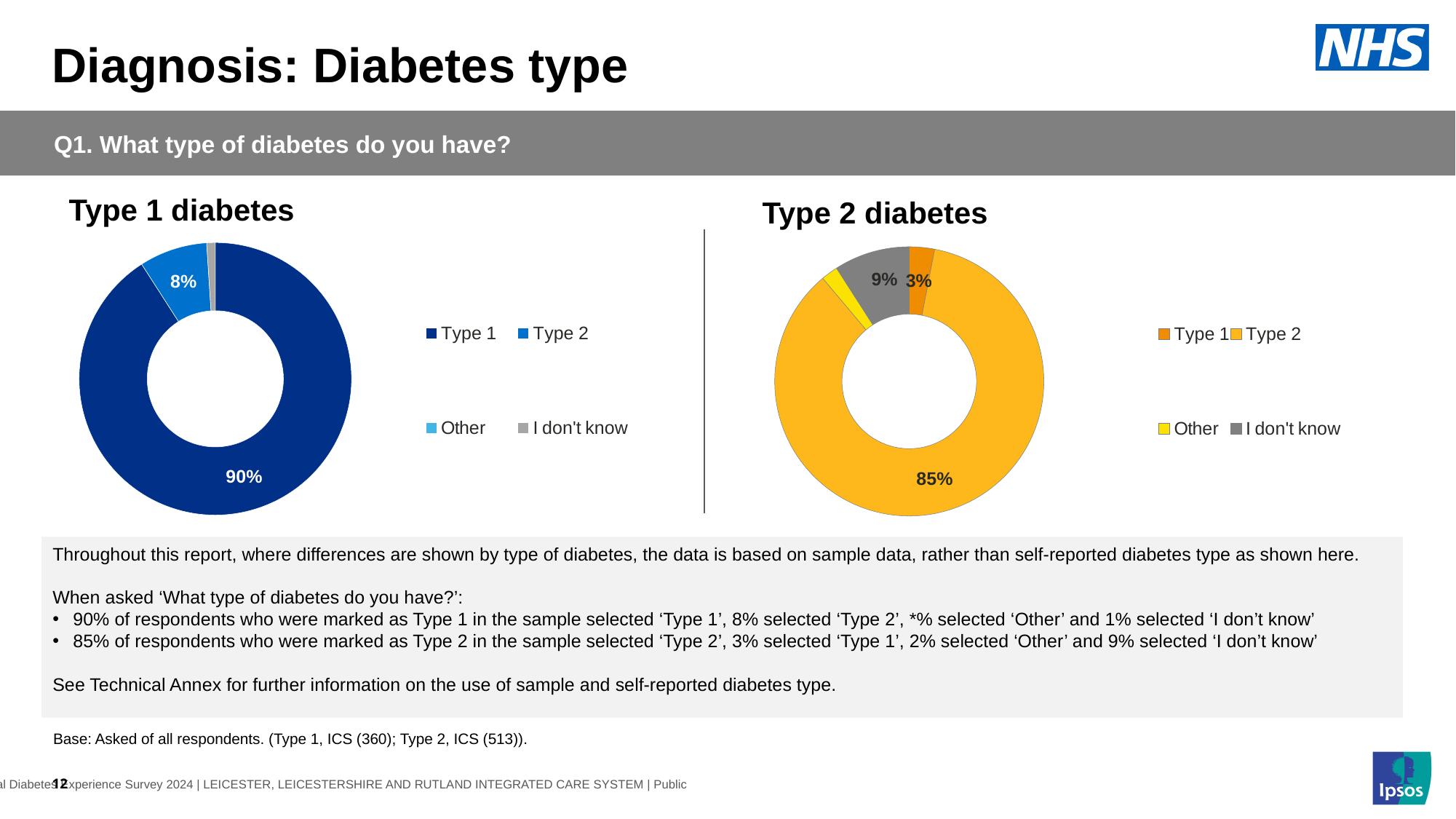
In the Type 2 diabetes chart, what percentage of respondents selected 'Type 2'? 85% In the Type 2 diabetes chart, what percentage of respondents selected 'Type 1'? 3% What kind of chart is used for the Type 1 diabetes chart? Doughnut (pie) chart In the Type 1 diabetes chart, which category has the largest slice? Type 1 In the Type 1 diabetes chart, what percentage of respondents selected 'Type 1'? 90% In the Type 2 diabetes chart, what percentage of respondents selected 'I don't know'? 9% In the Type 2 diabetes chart, what is the difference in percentage points between the 'Type 2' and 'I don't know' slices? 76 percentage points In the Type 1 diabetes chart, what percentage of respondents selected 'Type 2'? 8% In the Type 2 diabetes chart, which category has the largest slice? Type 2 In the Type 2 diabetes chart, which is larger: the 'I don't know' slice or the 'Type 1' slice? I don't know How many categories does the legend of the Type 2 diabetes chart list? 4 In the Type 1 diabetes chart, what is the difference in percentage points between the 'Type 1' and 'Type 2' slices? 82 percentage points